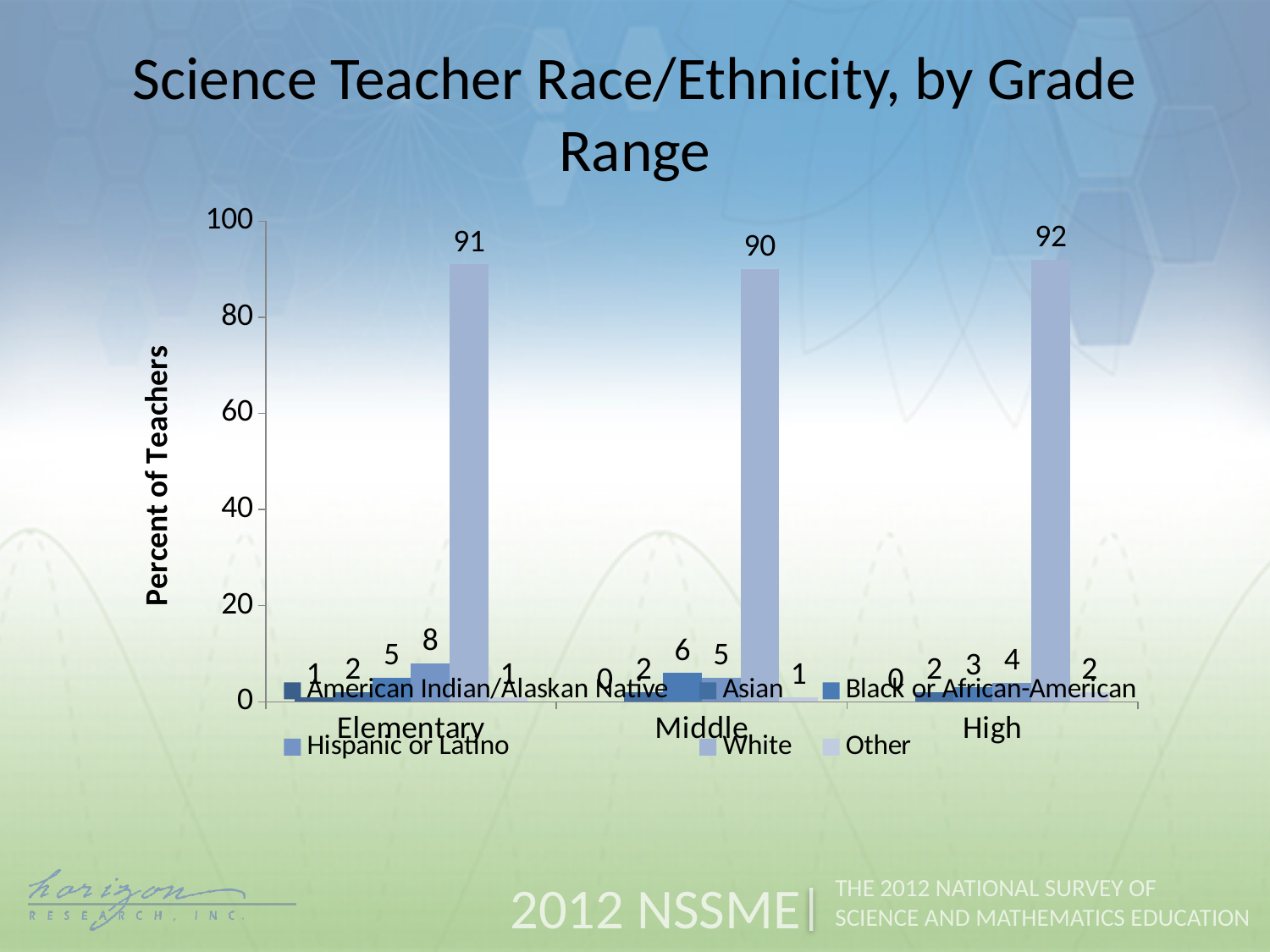
Which grade range has the highest percent of White science teachers? High What percent of middle school science teachers are Black or African-American? 6 Which grade range has the lowest percent of Hispanic or Latino science teachers? High What percent of high school science teachers are Hispanic or Latino? 4 How many race/ethnicity series does the legend list? 6 How many grade ranges are shown on the x axis? 3 Is the value for White elementary science teachers greater or less than 80? greater What percent of elementary science teachers are White? 91 What type of chart is shown on the slide? Bar chart What is the difference between the percent of White science teachers at the high school level and at the middle school level? 2 Is the percent of Hispanic or Latino science teachers higher at the elementary level or the high school level? Elementary What is the label of the y axis? Percent of Teachers